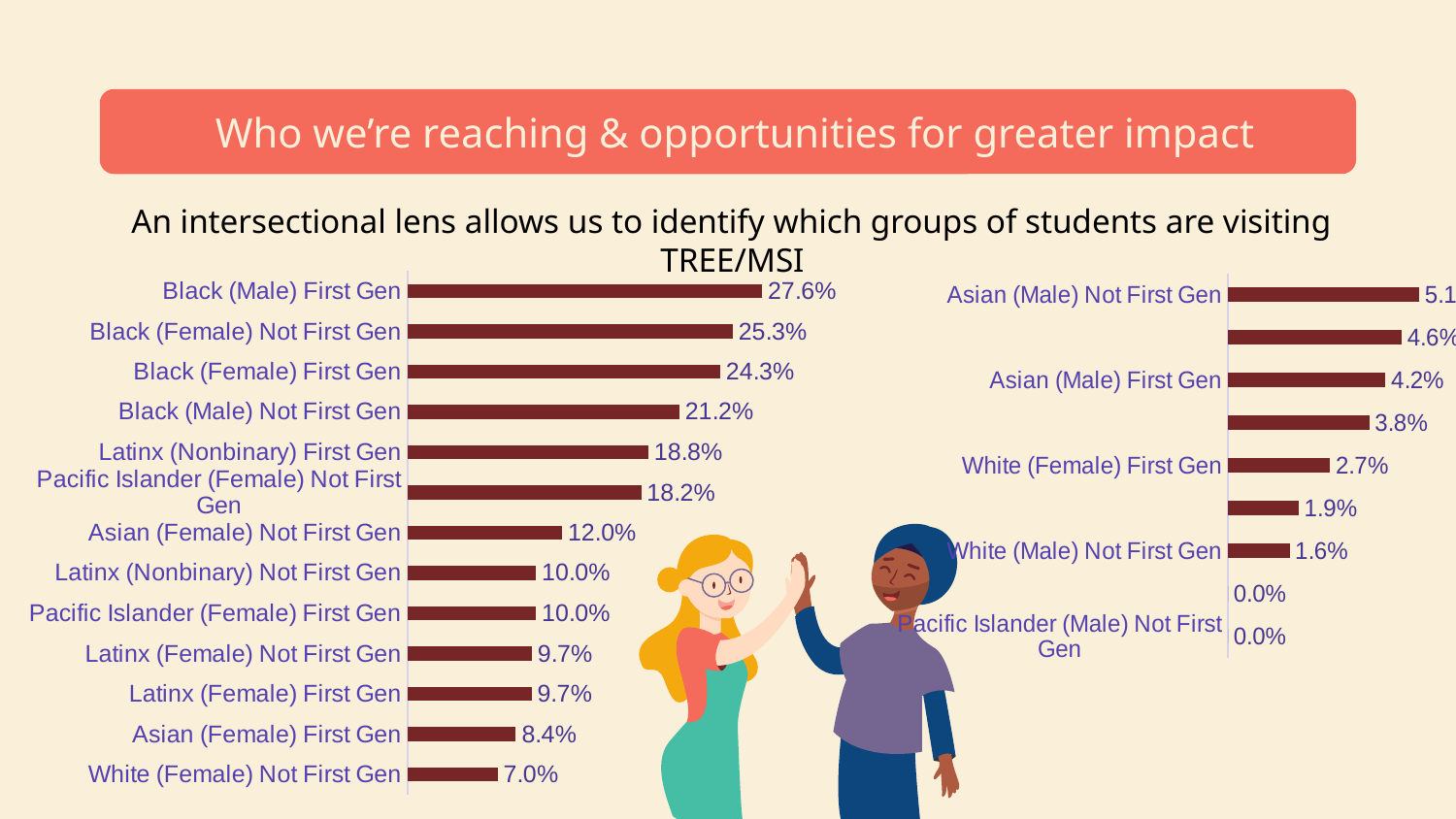
In the left chart, what is the value for Asian (Female) Not First Gen? 12.0% In the left chart, which is larger: Latinx (Nonbinary) First Gen or Pacific Islander (Female) Not First Gen? Latinx (Nonbinary) First Gen In the left chart, which category has the lowest value? White (Female) Not First Gen In the left chart, do the values increase or decrease going from the top bar to the bottom bar? decrease In the left chart, which category has the highest value? Black (Male) First Gen How many bars are shown in the left chart? 13 What kind of chart is the chart on the left side of the slide? bar chart In the left chart, what is the difference between Black (Female) Not First Gen and Black (Female) First Gen? 1.0% In the left chart, what is the value for Black (Male) First Gen? 27.6% In the right chart, what is the value for Asian (Male) First Gen? 4.2% In the right chart, what is the value for Pacific Islander (Male) Not First Gen? 0.0% In the right chart, what is the difference between Asian (Male) First Gen and White (Male) Not First Gen? 2.6%